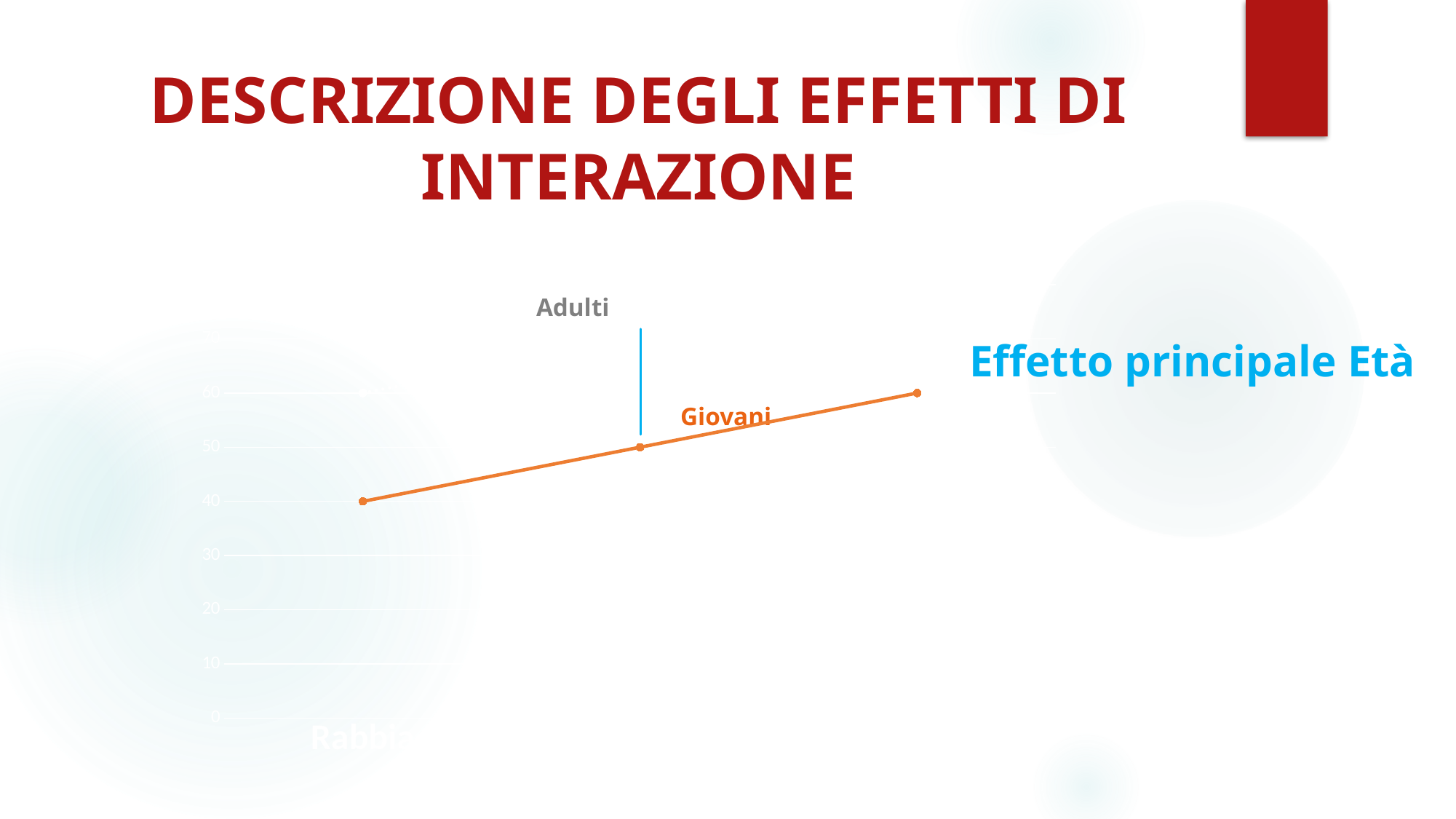
What is the value of the leftmost point on the Giovani line? 40 How many data points are plotted on the Giovani line? 3 What colour is the Giovani line? orange What is the value of the middle point on the Giovani line? 50 Which point on the Giovani line has the highest value? rightmost Is the value of the leftmost point on the Giovani line greater or less than 50? less What is the value of the rightmost point on the Giovani line? 60 What is the difference between the rightmost and leftmost values on the Giovani line? 20 What label is attached to the blue vertical line on the chart? Adulti Do the values of the Giovani line rise or fall from left to right? rise What kind of chart is shown on the slide? line chart Which point on the Giovani line is higher, the leftmost or the rightmost? rightmost